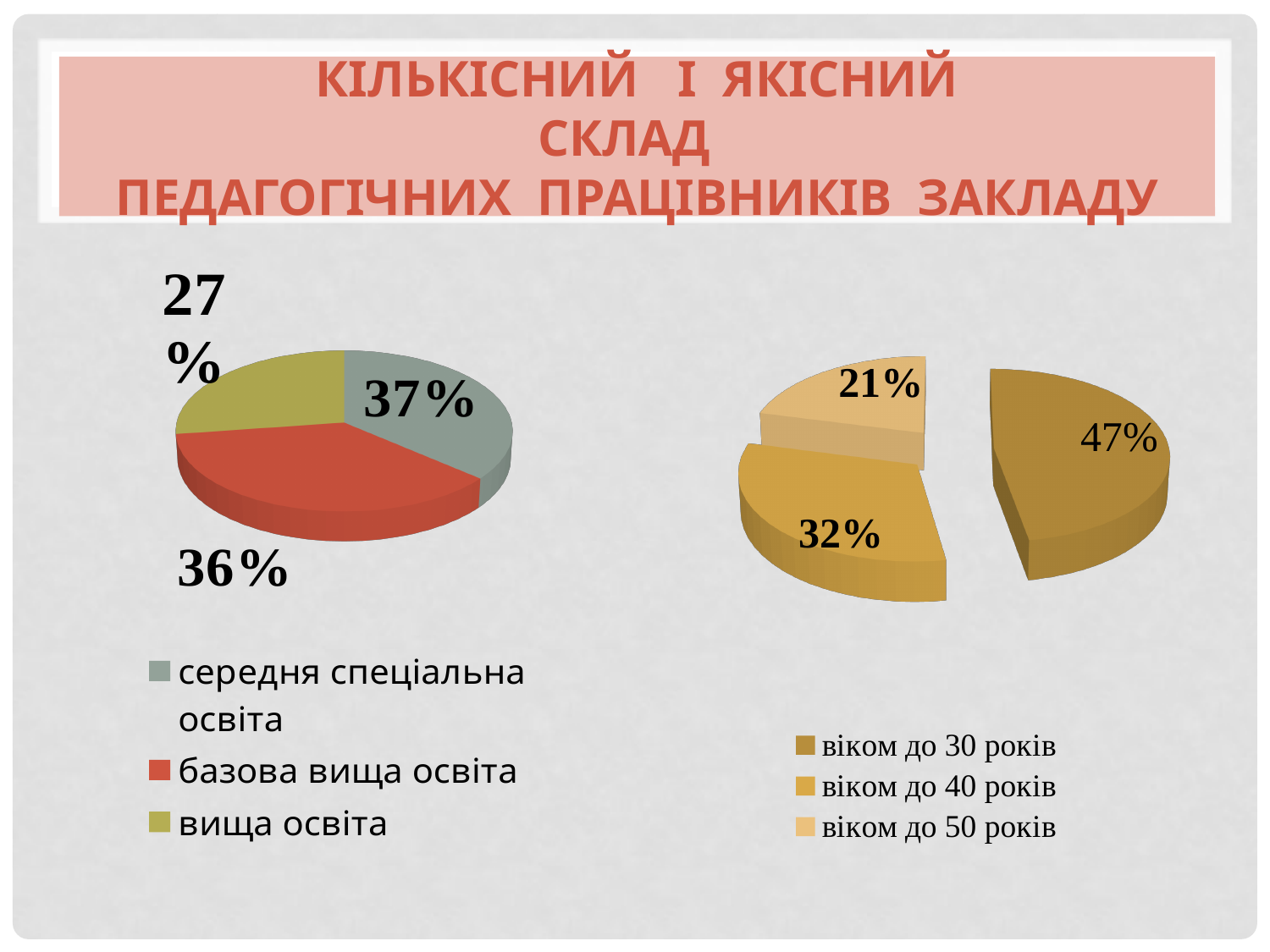
On the right pie chart, what is the difference between the shares for 'віком до 30 років' and 'віком до 50 років'? 26% On the left pie chart, which category has the smallest share? вища освіта On the left pie chart, how many categories does the legend list? 3 On the right pie chart, what share is labelled for 'віком до 30 років'? 47% On the left pie chart, what share is labelled for 'базова вища освіта'? 36% What type of chart is shown on the right side of the slide? pie chart On the right pie chart, what share is labelled for 'віком до 40 років'? 32% On the left pie chart, what share is labelled for 'середня спеціальна освіта'? 37% On the left pie chart, what share is labelled for 'вища освіта'? 27% On the right pie chart, which category has the largest share? віком до 30 років On the right pie chart, which is larger: the share for 'віком до 40 років' or for 'віком до 50 років'? віком до 40 років On the right pie chart, what share is labelled for 'віком до 50 років'? 21%